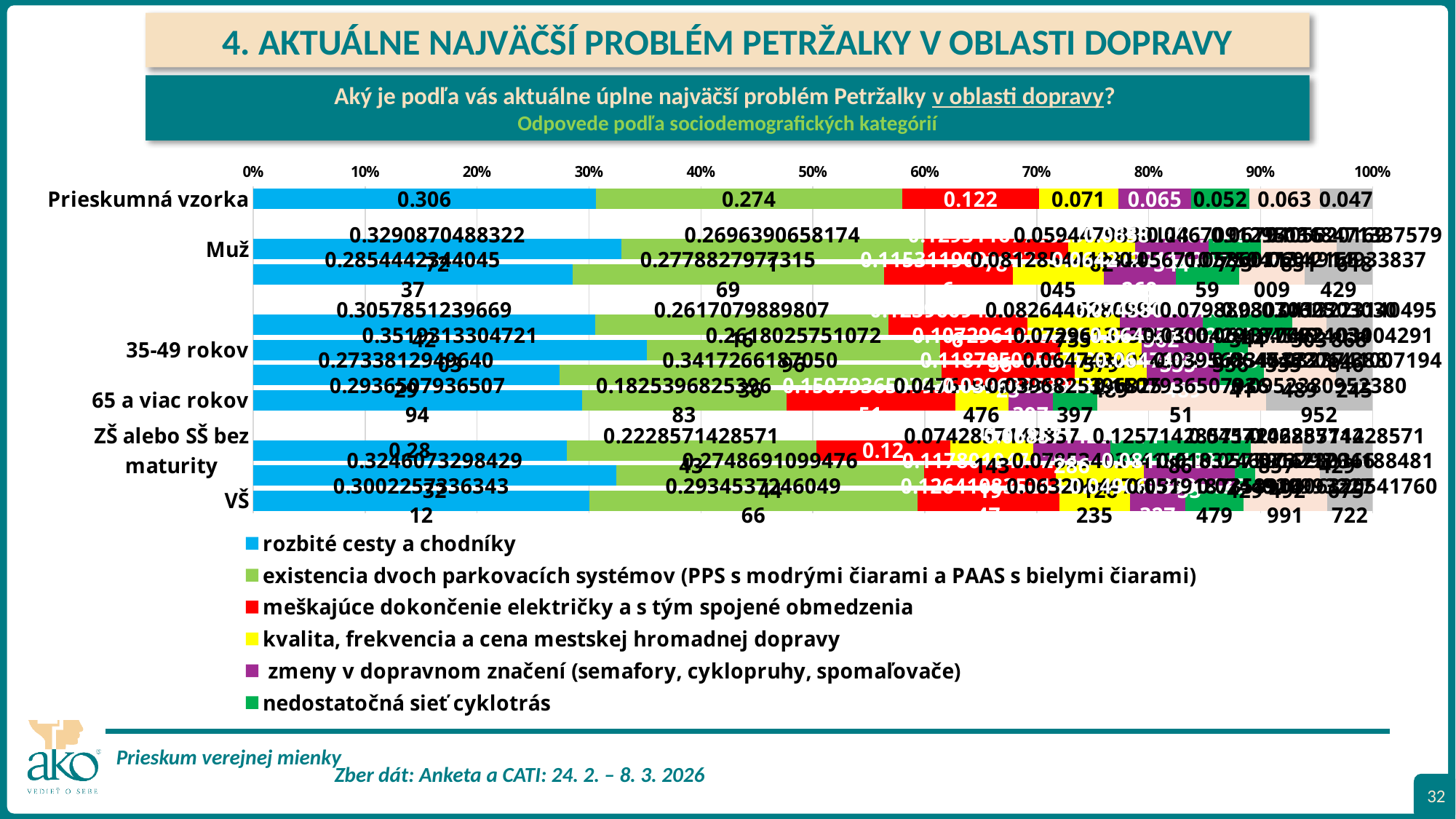
In the 'Prieskumná vzorka' row, which legend category has the highest value? rozbité cesty a chodníky What is the value for 'nedostatočná sieť cyklotrás' in the 'Prieskumná vzorka' row? 0.052 In the 'Prieskumná vzorka' row, which is larger: 'rozbité cesty a chodníky' or 'existencia dvoch parkovacích systémov'? rozbité cesty a chodníky How many series does the legend list? 6 What is the value for 'kvalita, frekvencia a cena mestskej hromadnej dopravy' in the 'Prieskumná vzorka' row? 0.071 In the 'Prieskumná vzorka' row, what is the difference between 'rozbité cesty a chodníky' (0.306) and 'existencia dvoch parkovacích systémov' (0.274)? 0.032 What kind of chart is shown on the slide? bar chart What is the value for 'rozbité cesty a chodníky' in the 'Prieskumná vzorka' row? 0.306 Which colour represents 'rozbité cesty a chodníky' in the legend? blue What is the value for 'zmeny v dopravnom značení' in the 'Prieskumná vzorka' row? 0.065 What is the value for 'meškajúce dokončenie električky a s tým spojené obmedzenia' in the 'Prieskumná vzorka' row? 0.122 What is the value for 'existencia dvoch parkovacích systémov' in the 'Prieskumná vzorka' row? 0.274